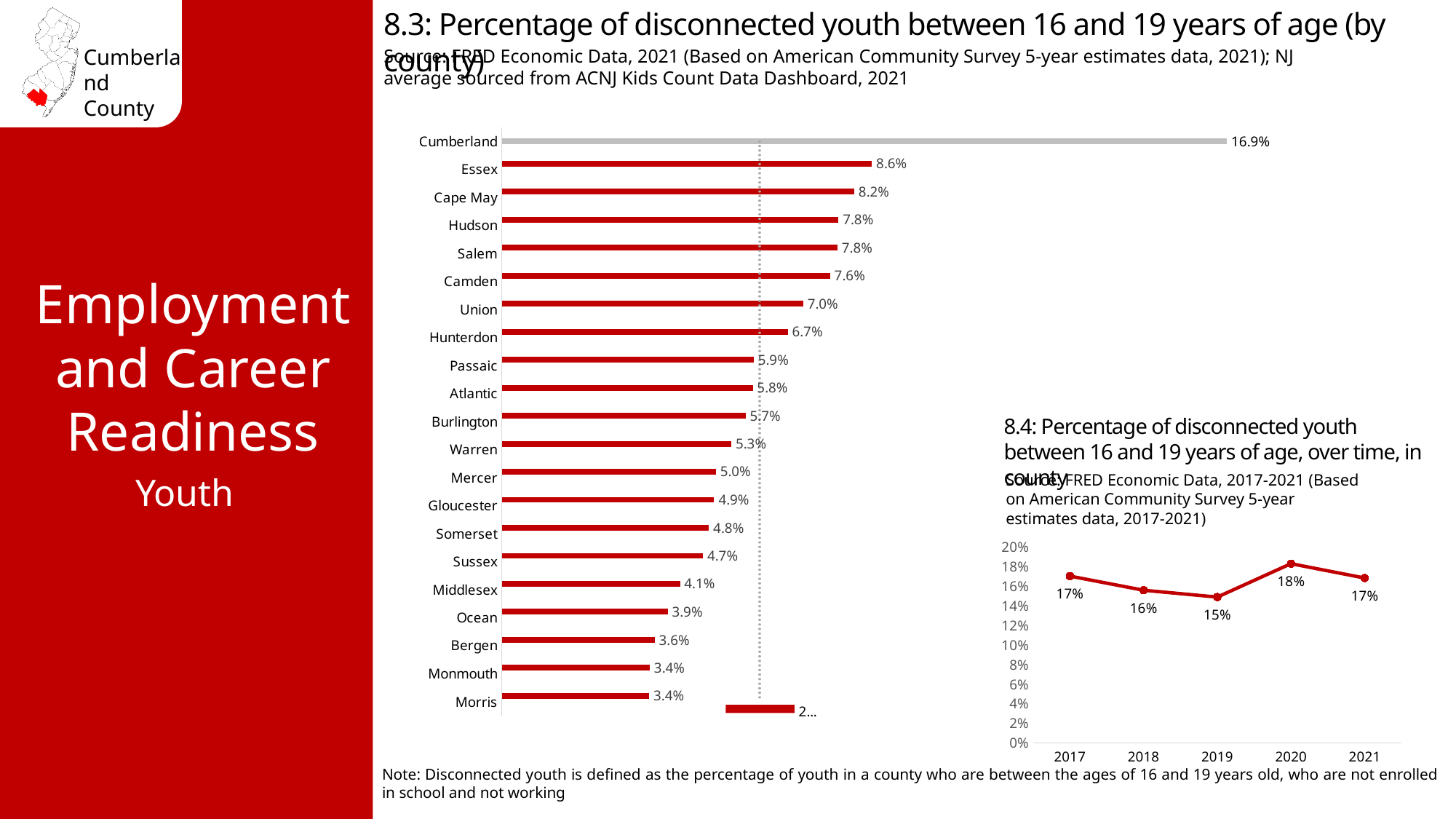
In chart 8.3, what is the difference between the values for Cumberland and Essex? 8.3% In chart 8.3, what is the value for Morris? 3.4% In chart 8.4, is the value for 2019 greater or less than 16%? less In chart 8.4, what is the value for 2020? 18% In chart 8.3, which has a larger value, Cape May or Camden? Cape May In chart 8.3, what is the percentage of disconnected youth for Cumberland? 16.9% In chart 8.4, which year has the lowest value? 2019 In chart 8.4, how many years are plotted? 5 What kind of chart is chart 8.4? Line chart In chart 8.3, what is the value for Essex? 8.6% In chart 8.3, which county has the highest percentage of disconnected youth? Cumberland What kind of chart is chart 8.3? Bar chart